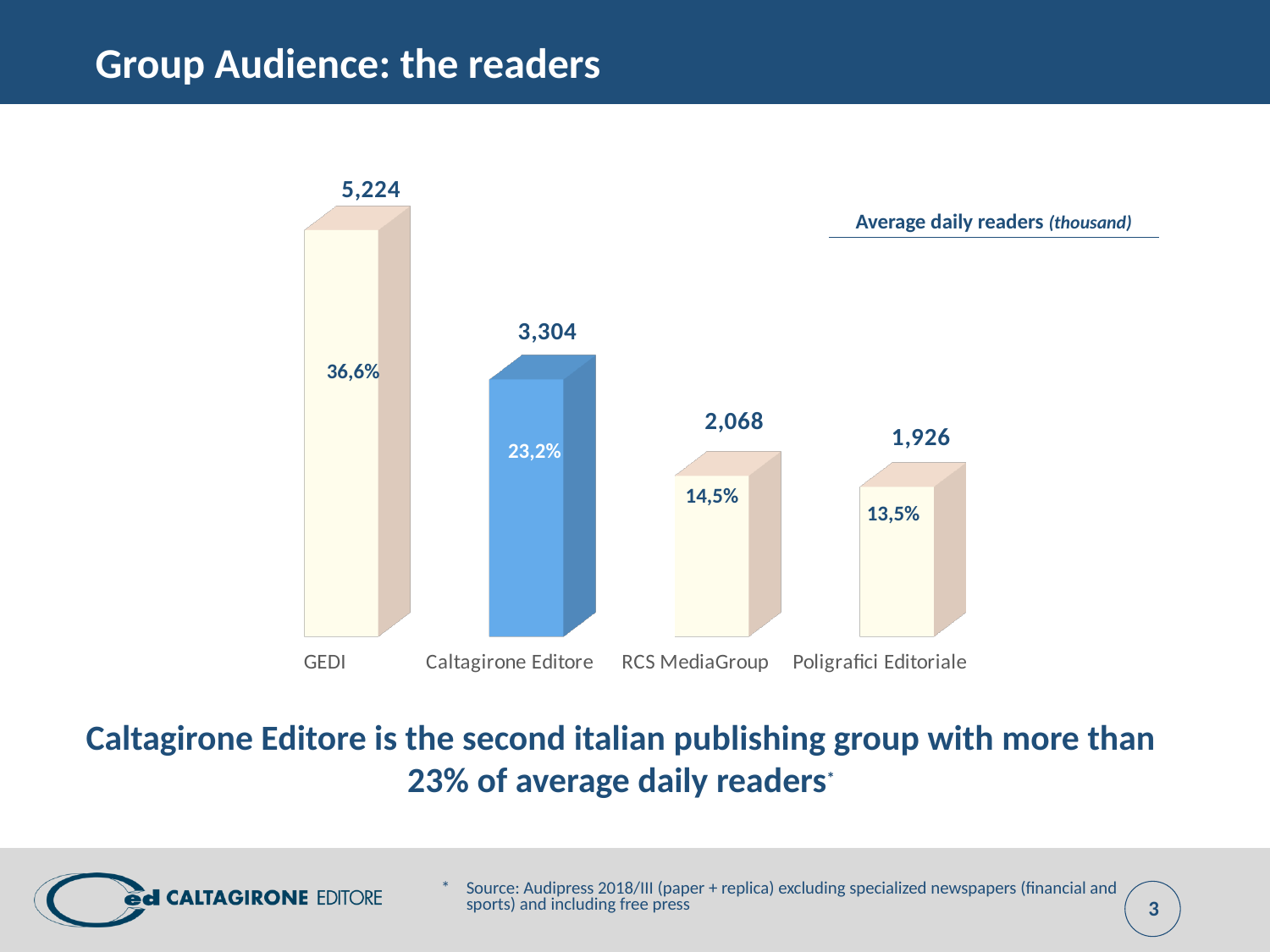
What is the average daily readers value for GEDI? 5,224 What percentage share is shown on the Poligrafici Editoriale bar? 13,5% How many publishing groups are shown in the chart? 4 Which has more average daily readers, Caltagirone Editore or RCS MediaGroup? Caltagirone Editore What is the difference in average daily readers between RCS MediaGroup and Poligrafici Editoriale? 142 What is the difference in average daily readers between GEDI and Caltagirone Editore? 1,920 Which bar in the chart is coloured blue? Caltagirone Editore Which publishing group has the highest average daily readers? GEDI What is the average daily readers value for Caltagirone Editore? 3,304 Which publishing group has the lowest average daily readers? Poligrafici Editoriale What is the average daily readers value for RCS MediaGroup? 2,068 What kind of chart is shown on the slide? Bar chart